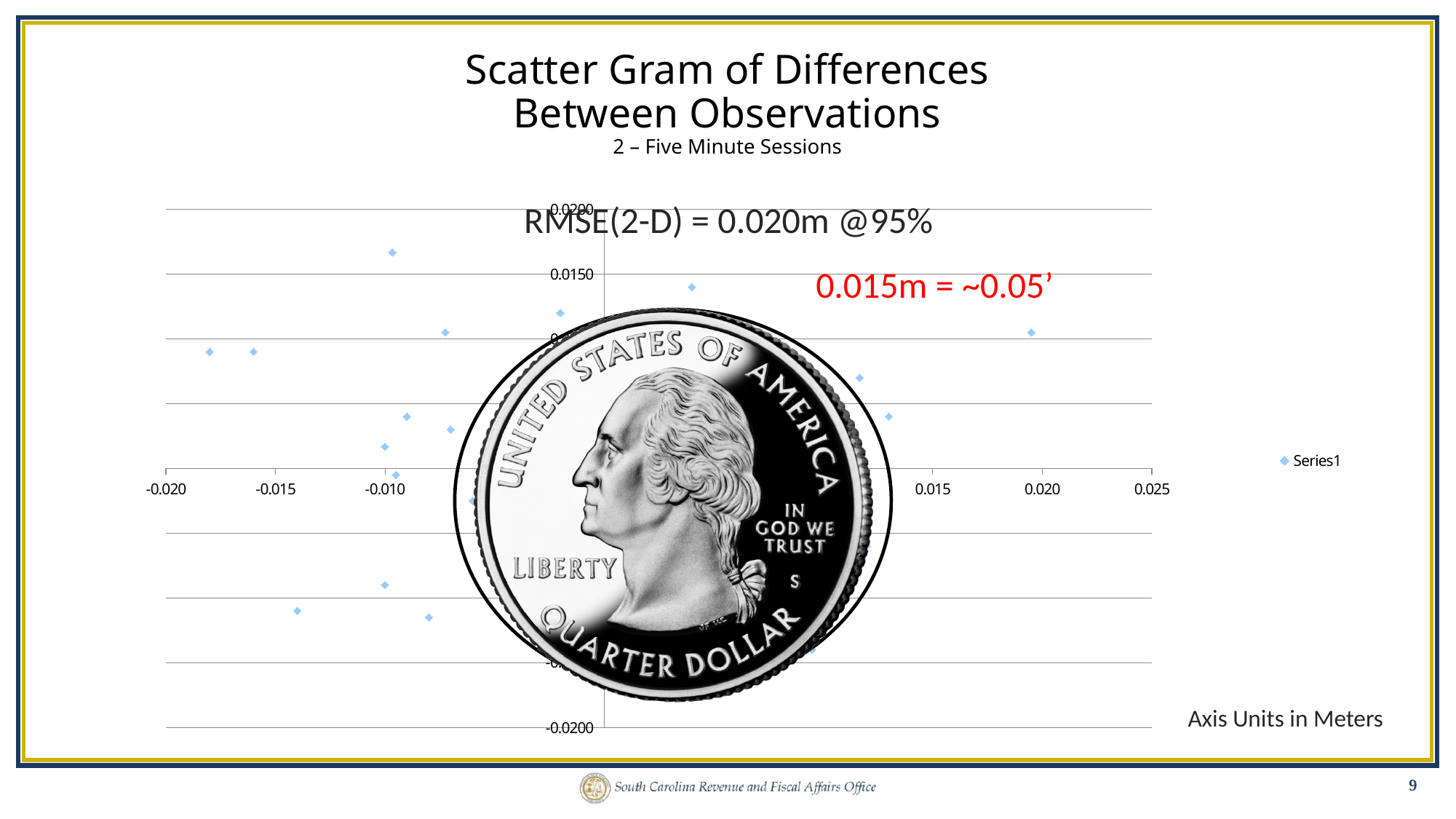
What units are the chart axes in, according to the slide? Meters What is the name of the series shown in the chart legend? Series1 What is the lowest value labelled on the y axis? -0.0200 Is the y value of the highest plotted point greater or less than 0.0150? greater How many series does the chart legend list? 1 What kind of chart is shown on the slide? scatter chart What is the largest value labelled on the x axis? 0.025 Is the x value of the leftmost plotted point greater or less than -0.015? less What RMSE(2-D) value is stated on the chart? 0.020m @95%